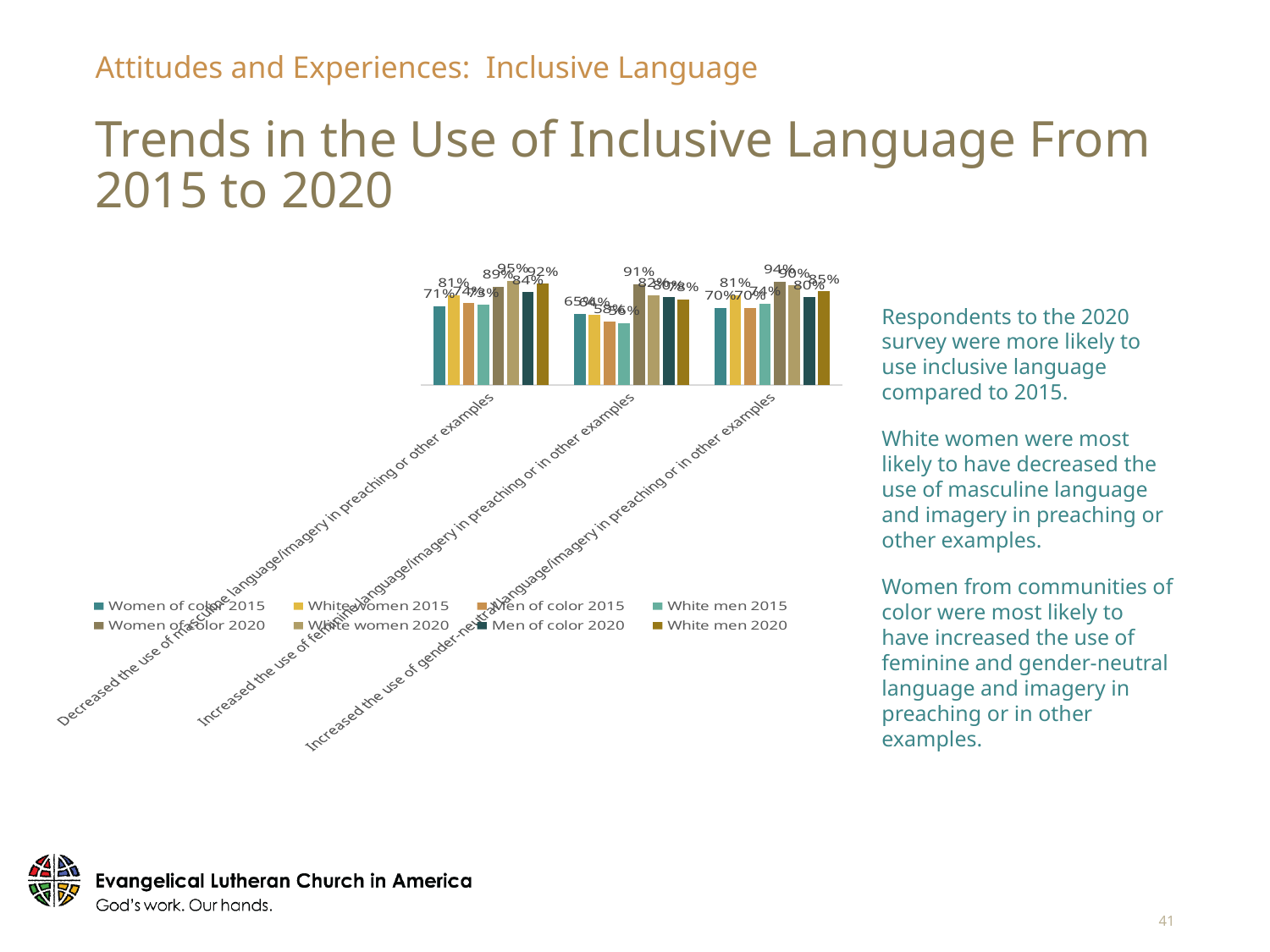
How many series does the chart legend list? 8 Which series has the highest value in the 'Increased the use of feminine language/imagery in preaching or in other examples' category? Women of color 2020 How many categories are shown along the x axis of the chart? 3 What kind of chart is shown on the slide? Bar chart What is the value for Women of color 2015 in the 'Decreased the use of masculine language/imagery in preaching or other examples' category? 71% What is the value for Women of color 2020 in the 'Increased the use of feminine language/imagery in preaching or in other examples' category? 91% Which series has the highest value in the 'Decreased the use of masculine language/imagery in preaching or other examples' category? White women 2020 In the 'Decreased the use of masculine language/imagery in preaching or other examples' category, which is larger: Women of color 2015 or Women of color 2020? Women of color 2020 What is the value for White women 2020 in the 'Decreased the use of masculine language/imagery in preaching or other examples' category? 95% What is the value for Women of color 2020 in the 'Increased the use of gender-neutral language/imagery in preaching or in other examples' category? 94% What is the title of the chart's slide? Trends in the Use of Inclusive Language From 2015 to 2020 In the 'Decreased the use of masculine language/imagery in preaching or other examples' category, what is the difference between White women 2020 and Women of color 2015? 24 percentage points